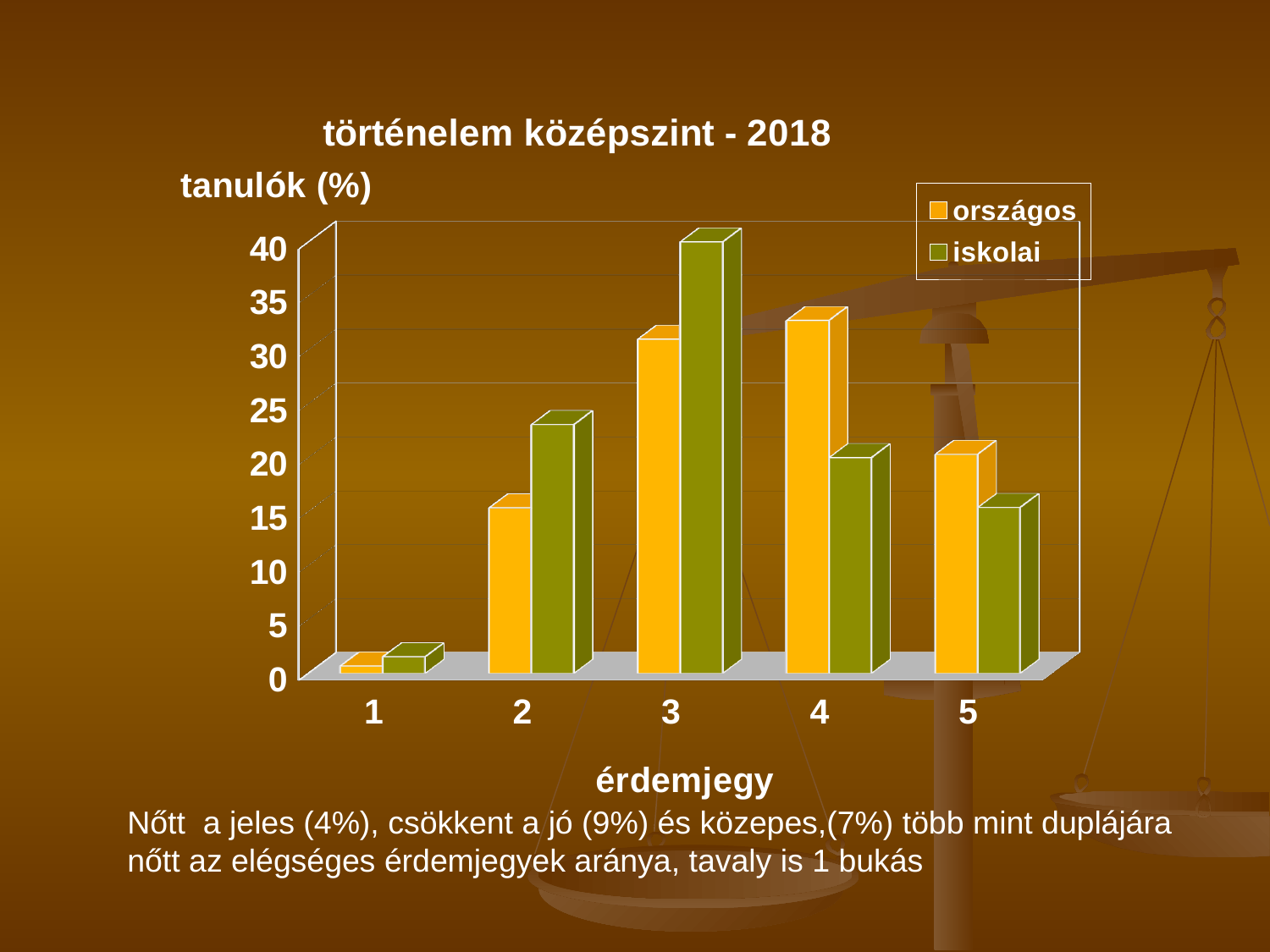
Is the országos value for grade 4 greater or less than 30? greater How many grade categories (érdemjegy) are shown on the x axis? 5 For which grade is the iskolai value lowest? 1 Is the iskolai value for grade 3 greater or less than 35? greater Is the országos value for grade 2 greater or less than 20? less For which grade is the iskolai value highest? 3 How many series does the legend list? 2 Which two series are listed in the legend? országos, iskolai For grade 3, which series has the larger value, országos or iskolai? iskolai What is the title of the chart? történelem középszint - 2018 For grade 4, which series has the larger value, országos or iskolai? országos What kind of chart is shown on the slide? bar chart